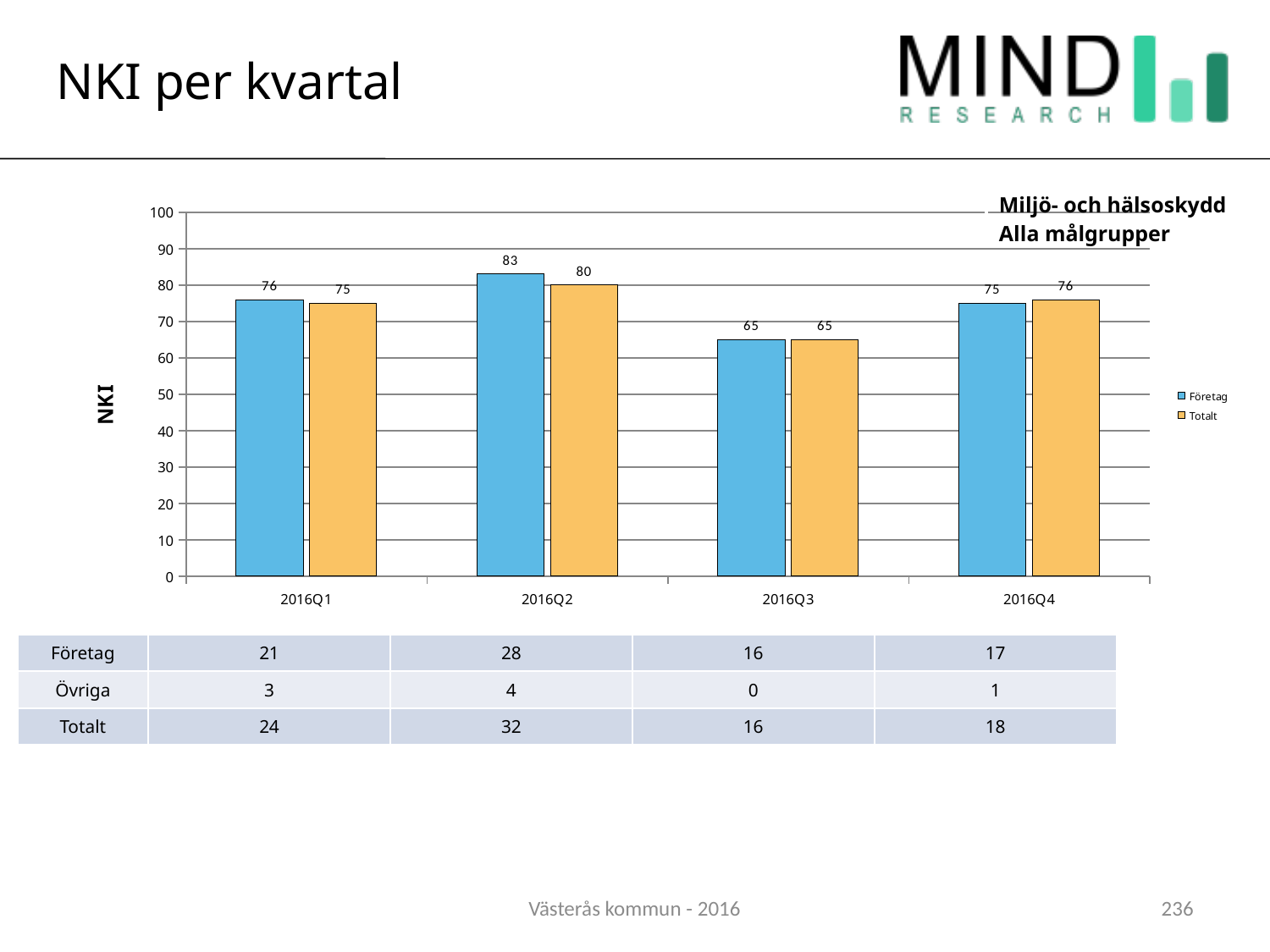
How many series does the legend list? 2 What is the label on the y axis of the chart? NKI What is the difference between the Företag and Totalt values for 2016Q2? 3 Which quarter has the lowest Totalt value? 2016Q3 Which quarter has the highest Företag value? 2016Q2 What is the Företag value for 2016Q2? 83 What is the Totalt value for 2016Q4? 76 How many quarters are shown on the x axis? 4 What is the Totalt value for 2016Q1? 75 What kind of chart is shown on the slide? bar chart Which is larger, the Totalt value for 2016Q2 or the Totalt value for 2016Q4? 2016Q2 What is the difference between the Företag value for 2016Q2 and the Företag value for 2016Q3? 18